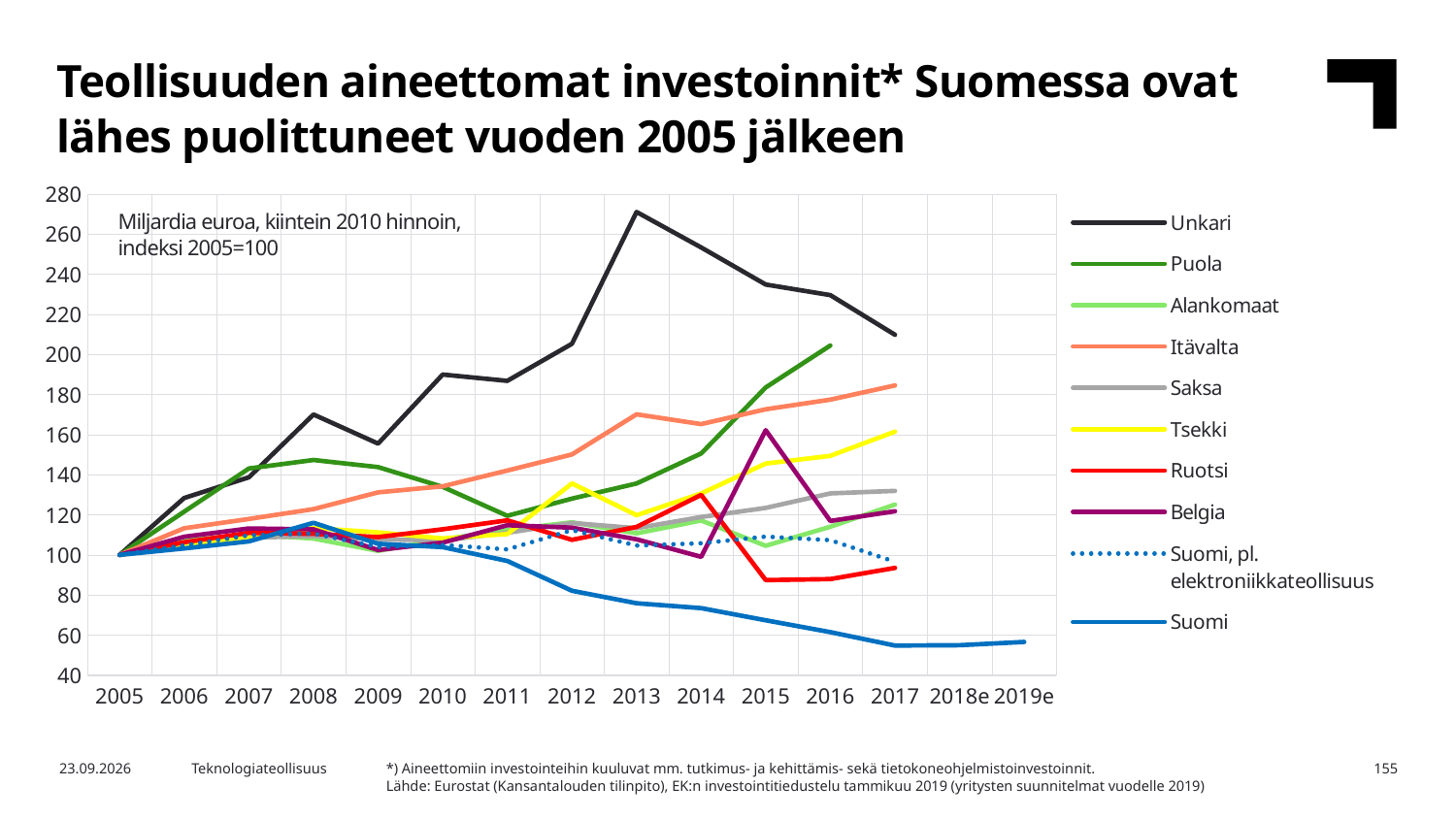
Does the value for Suomi rise or fall from 2008 to 2017? fall How many series does the legend list? 10 Which series has the lowest value in 2017? Suomi Which series has the highest value in 2013? Unkari What is the index value of all series in 2005, according to the note on the chart? 100 Is the value for Suomi in 2012 greater or less than 100? less Is the value for Unkari in 2013 greater or less than 260? greater Is the value for Suomi in 2017 greater or less than 60? less How many years are shown on the x axis? 15 What kind of chart is shown on the slide? line chart Which is larger in 2016, the value for Puola or the value for Ruotsi? Puola Which legend entry is drawn with a dotted line? Suomi, pl. elektroniikkateollisuus